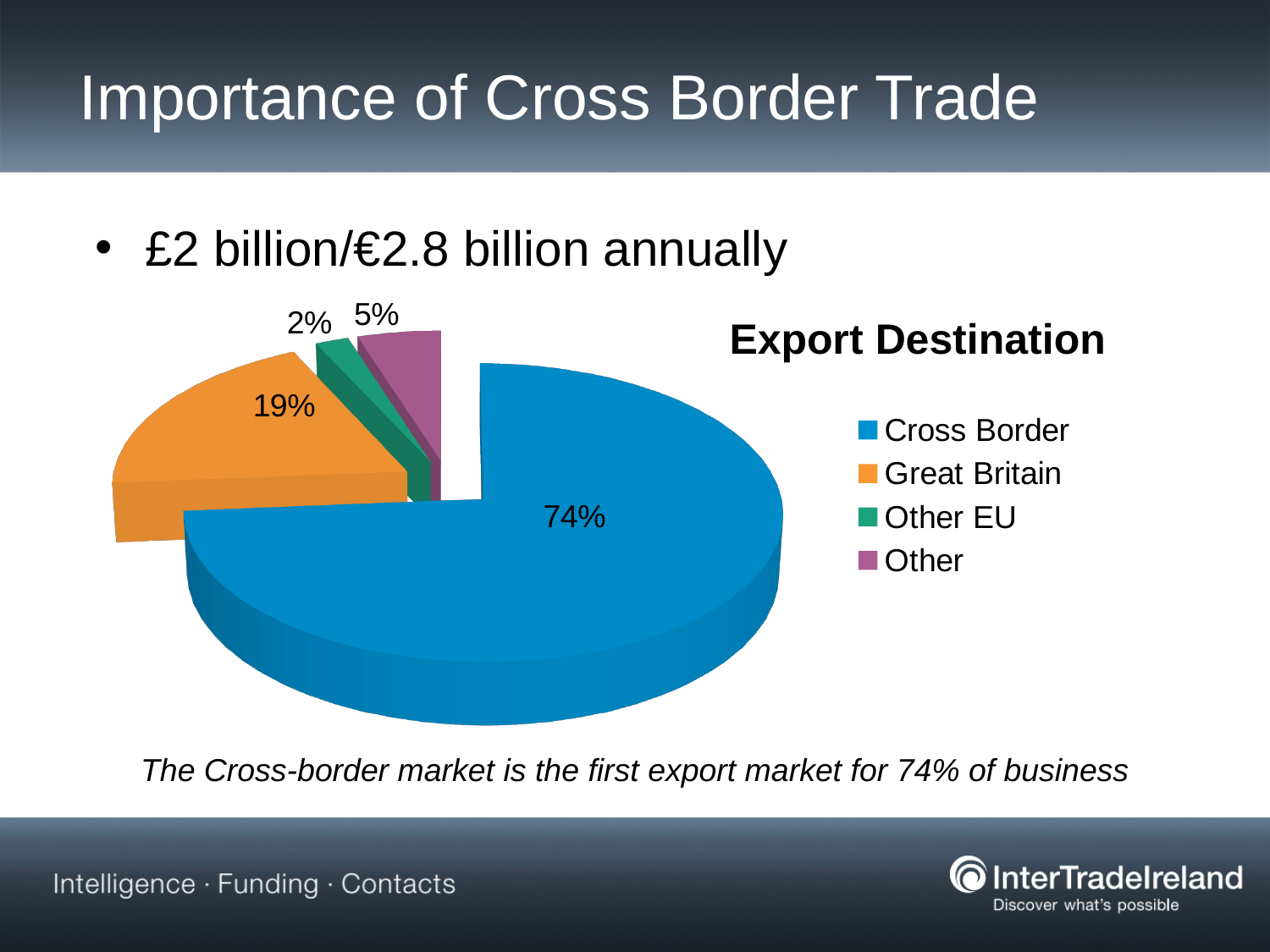
What is the difference between the Cross Border share and the Great Britain share? 55% Which is larger, the share for Other or the share for Other EU? Other Which export destination has the smallest share? Other EU What type of chart is shown on the slide? Pie chart Which colour represents Great Britain in the legend? Orange How many categories does the pie chart show? 4 What share of the pie does Other EU represent? 2% What share of the pie does Cross Border represent? 74% Which export destination has the largest share? Cross Border What is the title of the chart? Export Destination What share of the pie does Other represent? 5%